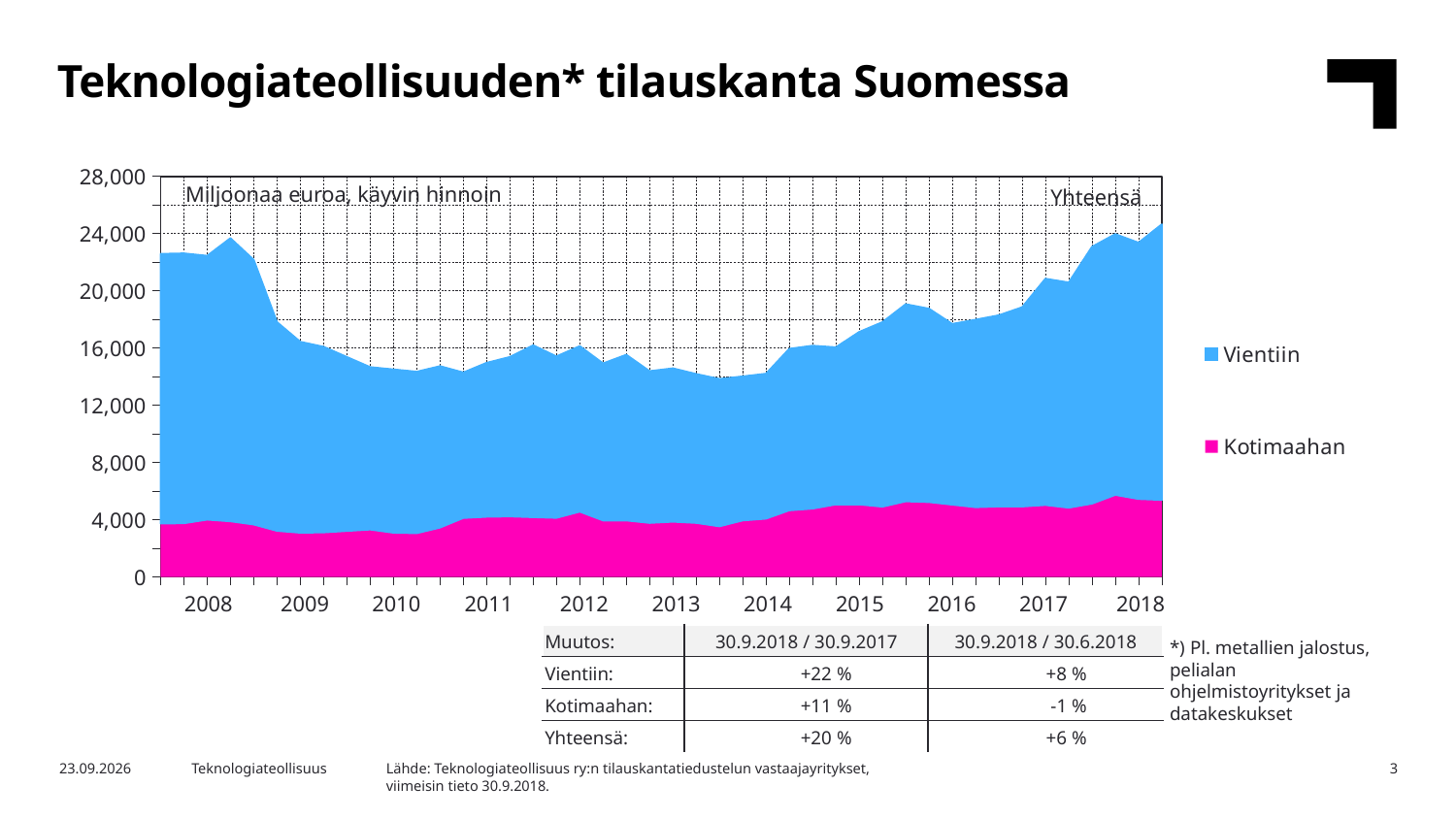
Which series is larger throughout the chart, Vientiin or Kotimaahan? Vientiin Which two series are listed in the chart legend? Vientiin and Kotimaahan Is the Kotimaahan value in 2009 greater or less than 4,000? less How many years are labelled on the x axis of the chart? 11 Does the total order book (Yhteensä) rise or fall from 2016 to 2018? rise Does the total order book (Yhteensä) rise or fall from 2008 to 2009? fall Is the total (Yhteensä) value at the end of 2018 greater or less than 20,000? greater Is the total (Yhteensä) value in 2013 greater or less than 16,000? less How many series does the chart legend list? 2 What unit label is shown inside the chart area at the top left? Miljoonaa euroa, käyvin hinnoin What kind of chart is shown on the slide? Stacked area chart